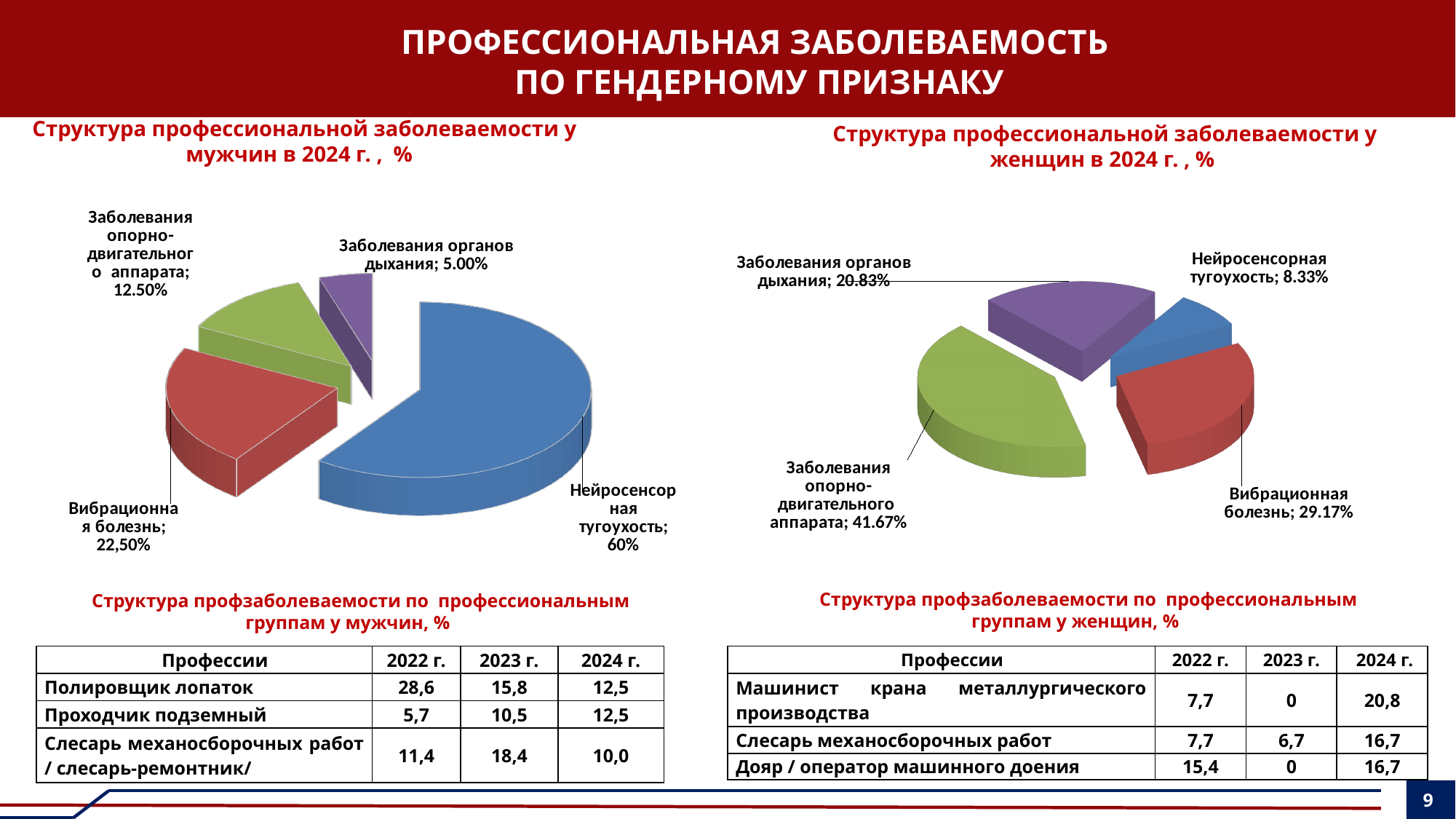
In the pie chart for men in 2024, what share is Нейросенсорная тугоухость? 60% In the pie chart for women in 2024, which category has the largest share? Заболевания опорно-двигательного аппарата In the pie chart for women in 2024, what share is Вибрационная болезнь? 29.17% In the pie chart for men in 2024, which category has the smallest share? Заболевания органов дыхания In the pie chart for men in 2024, what share is Заболевания органов дыхания? 5.00% In the pie chart for women in 2024, what share is Нейросенсорная тугоухость? 8.33% In the pie chart for men in 2024, what share is Вибрационная болезнь? 22,50% In the pie chart for women in 2024, what share is Заболевания опорно-двигательного аппарата? 41.67% What type of chart is used for the structure of occupational morbidity among men in 2024? Pie chart In the pie chart for men in 2024, how many categories are shown? 4 In the pie chart for women in 2024, what is the difference between the shares of Заболевания органов дыхания and Нейросенсорная тугоухость? 12.50% In the pie chart for men in 2024, which is larger: Заболевания опорно-двигательного аппарата or Вибрационная болезнь? Вибрационная болезнь